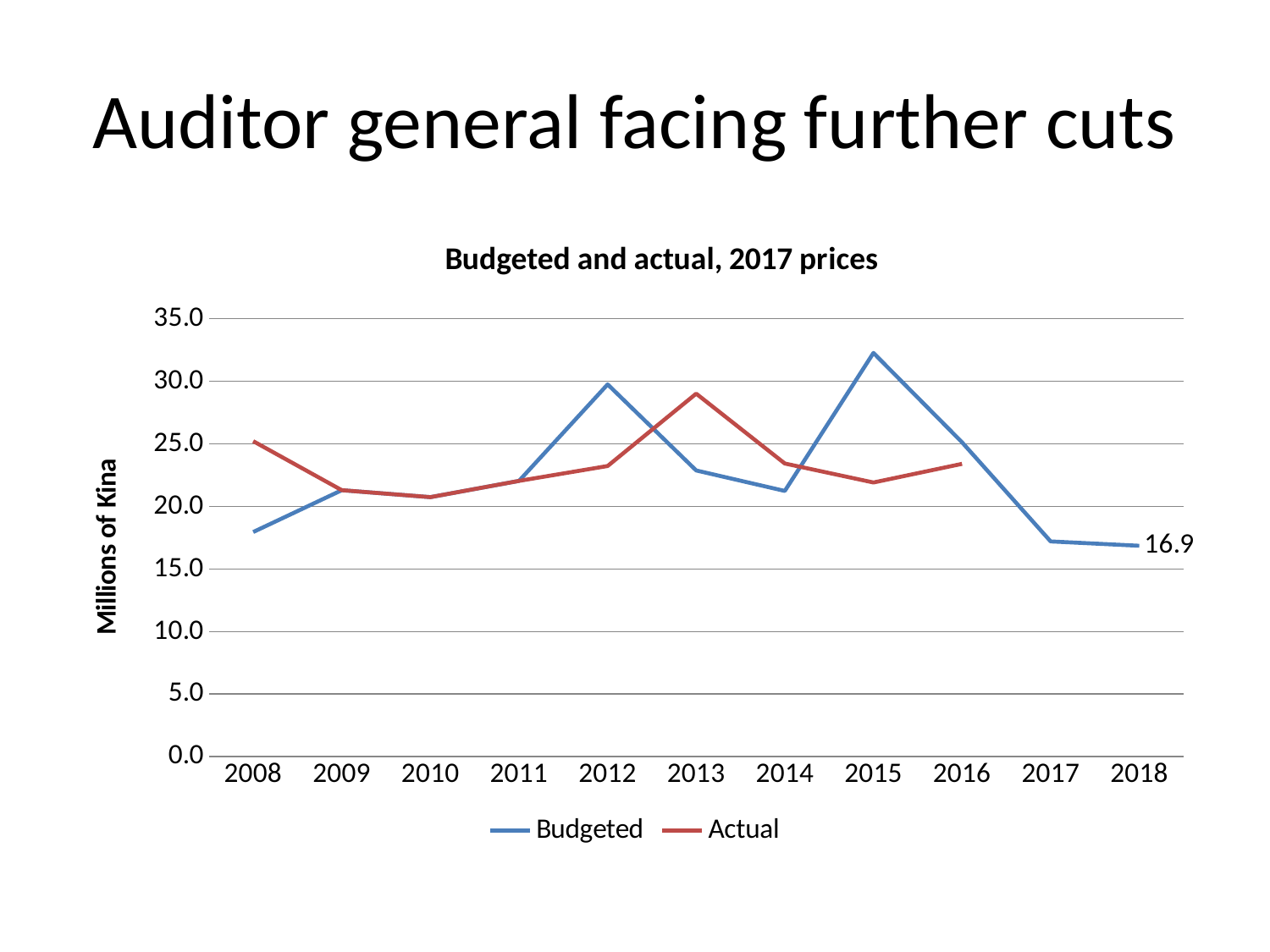
In 2008, which is larger, the Budgeted value or the Actual value? Actual How many years are shown on the x axis? 11 Is the Budgeted value for 2017 greater or less than 20.0? less Does the Budgeted line rise or fall from 2015 to 2018? fall What kind of chart is shown on the slide? line chart In which year is the Actual value highest? 2013 What is the label on the vertical axis? Millions of Kina How many series does the legend list? 2 Is the Budgeted value for 2015 greater or less than 30.0? greater In which year is the Budgeted value highest? 2015 What is the Budgeted value for 2018? 16.9 In 2013, which is larger, the Budgeted value or the Actual value? Actual